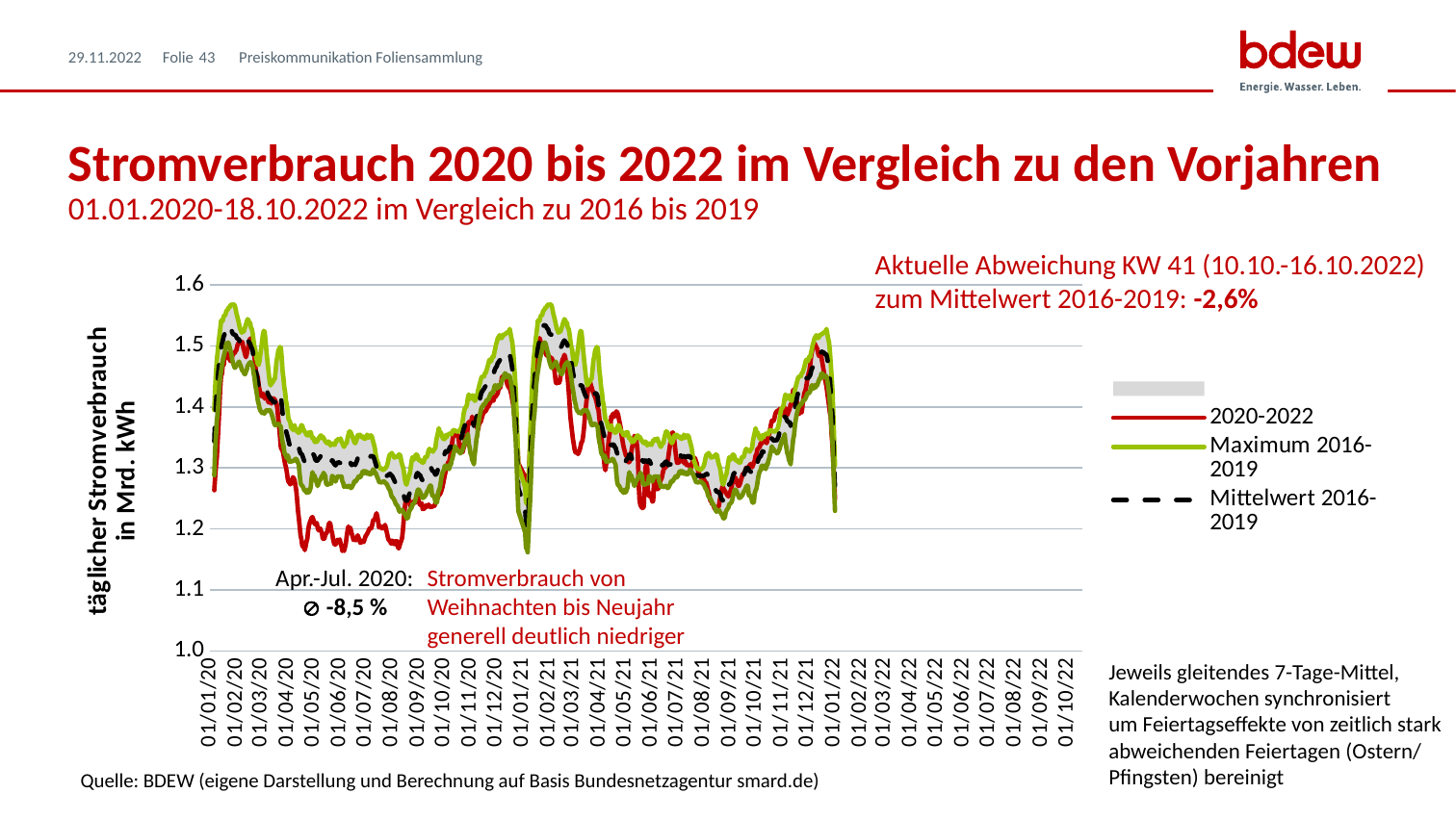
How many named series does the legend list? 3 What colour is the line for the series 2020-2022? red Does the 2020-2022 series rise or fall between 01/02/20 and 01/05/20? fall Is the value of the Maximum 2016-2019 series around 01/02/20 greater or less than 1.4? greater What is the highest tick value shown on the vertical axis? 1.6 According to the annotation, what is the current deviation in KW 41 (10.10.-16.10.2022) from the 2016-2019 mean? -2,6% Is the value of the 2020-2022 series around 01/05/20 greater or less than 1.3? less What kind of chart is shown on the slide? line chart What is the label of the vertical axis? täglicher Stromverbrauch in Mrd. kWh Around 01/05/20, which is higher: the 2020-2022 series or the Mittelwert 2016-2019 series? Mittelwert 2016-2019 Does the 2020-2022 series rise or fall between 01/09/21 and 01/12/21? rise According to the annotation, what was the average deviation in Apr.-Jul. 2020? -8,5 %